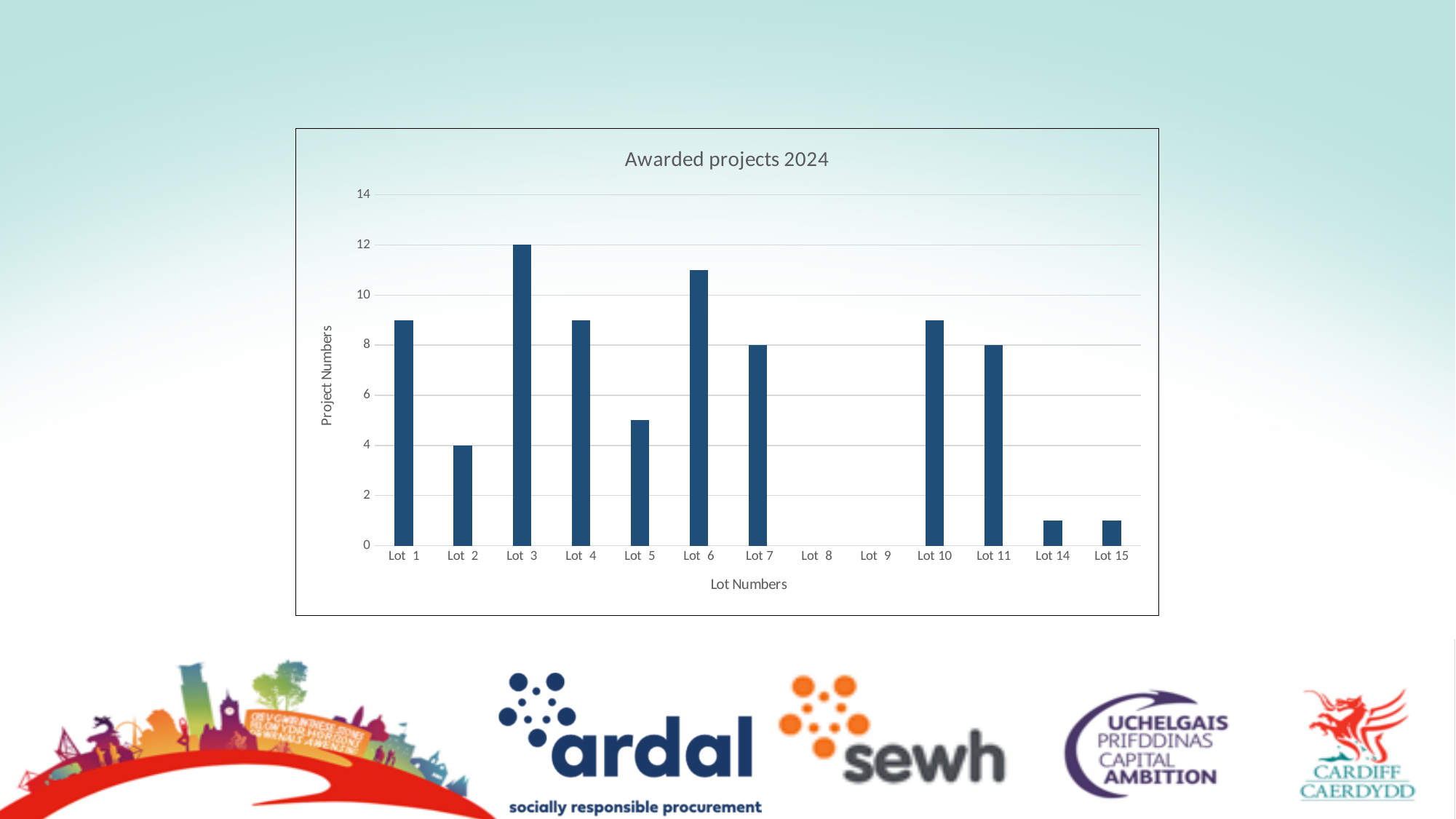
What is the value for Lot 3? 12 Which lot has the highest number of awarded projects? Lot 3 What is the value for Lot 2? 4 Is the value for Lot 14 greater or less than 2? less Which is larger, the value for Lot 2 or the value for Lot 5? Lot 5 What is the value for Lot 7? 8 Is the value for Lot 6 greater or less than 10? greater What is the label of the vertical axis? Project Numbers What is the title of the chart? Awarded projects 2024 What type of chart is shown on the slide? Bar chart How many lot categories are shown on the x axis? 13 What is the difference between the values for Lot 3 and Lot 7? 4